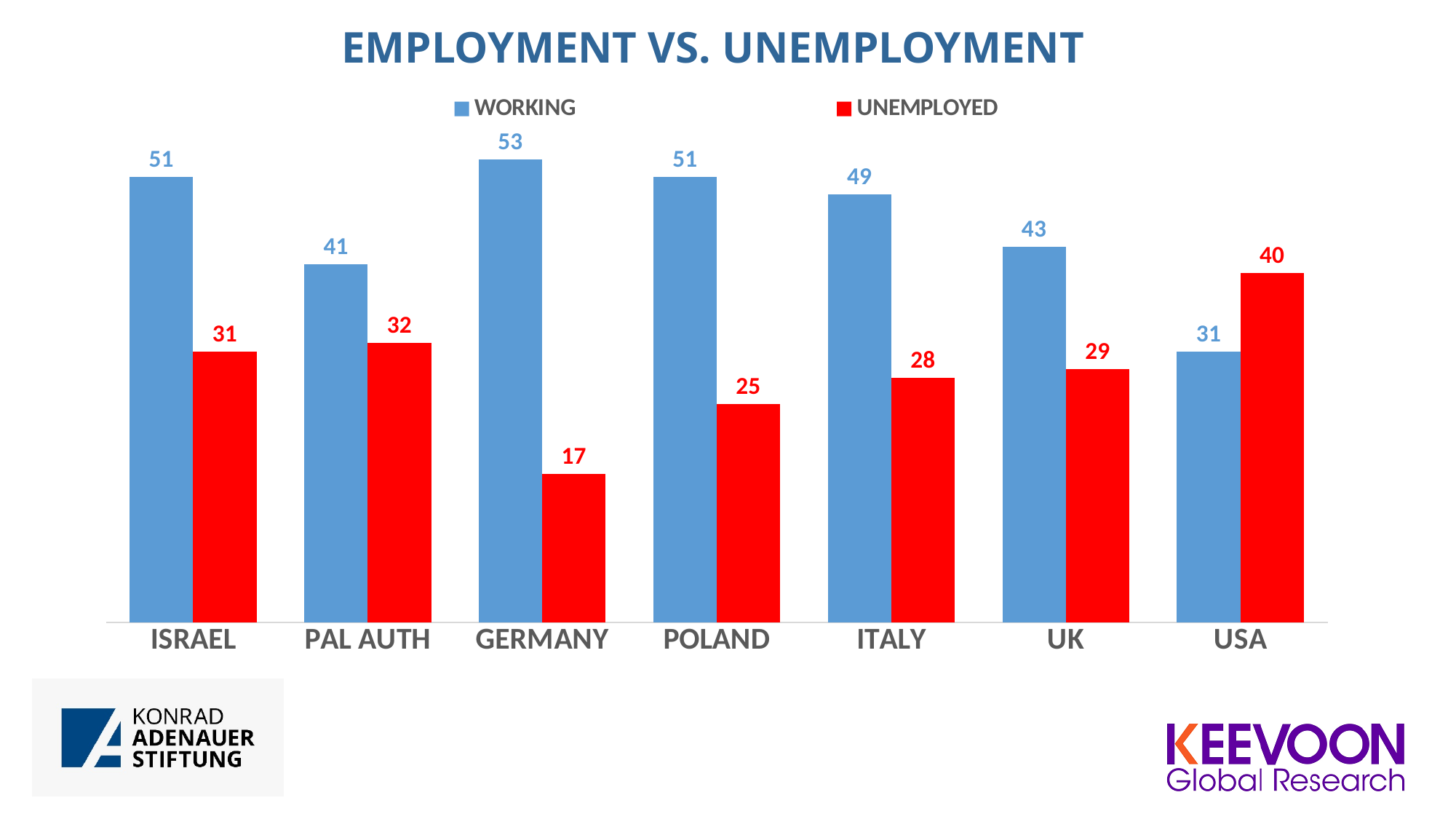
What is the WORKING value for GERMANY? 53 How many countries are shown on the x axis? 7 What is the UNEMPLOYED value for POLAND? 25 Which country has the lowest UNEMPLOYED value? GERMANY What kind of chart is shown on the slide? Bar chart What is the UNEMPLOYED value for USA? 40 Which country has the lowest WORKING value? USA What is the title of the chart? EMPLOYMENT VS. UNEMPLOYMENT What is the difference between the WORKING and UNEMPLOYED values for ITALY? 21 Which is larger for USA, the WORKING value or the UNEMPLOYED value? UNEMPLOYED Which country has the highest WORKING value? GERMANY How many series does the legend list? 2